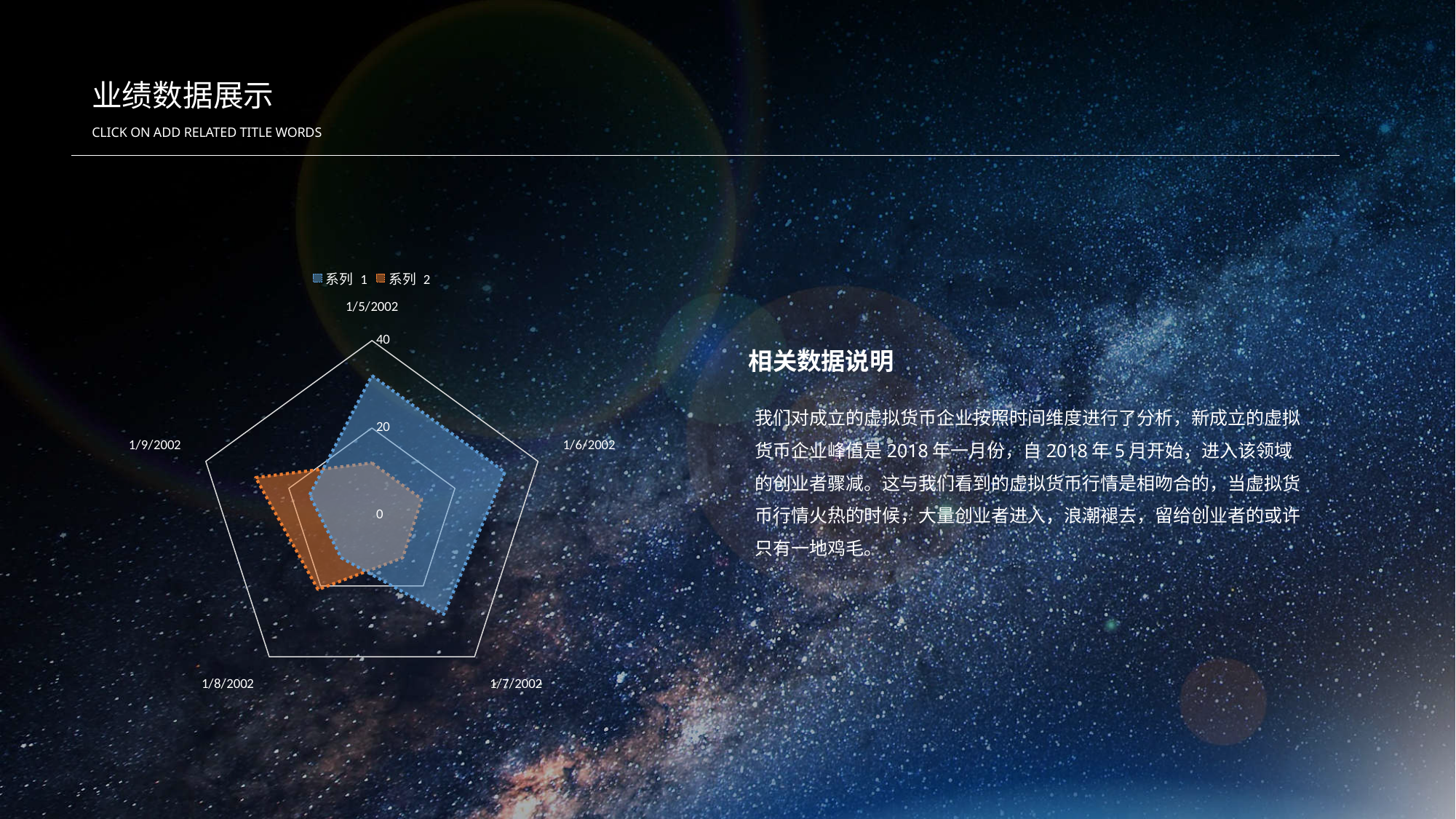
Is the value of 系列 1 for 1/6/2002 greater or less than 20? greater How many series does the legend of the radar chart list? 2 Is the value of 系列 2 for 1/7/2002 greater or less than 20? less What are the names of the two series in the legend? 系列 1 and 系列 2 What is the highest value shown on the radar chart's axis? 40 What kind of chart is shown on the slide? radar chart For 1/9/2002, which series has the larger value, 系列 1 or 系列 2? 系列 2 How many categories (dates) does the radar chart have? 5 Is the value of 系列 1 for 1/5/2002 greater or less than 20? greater For 1/5/2002, which series has the larger value, 系列 1 or 系列 2? 系列 1